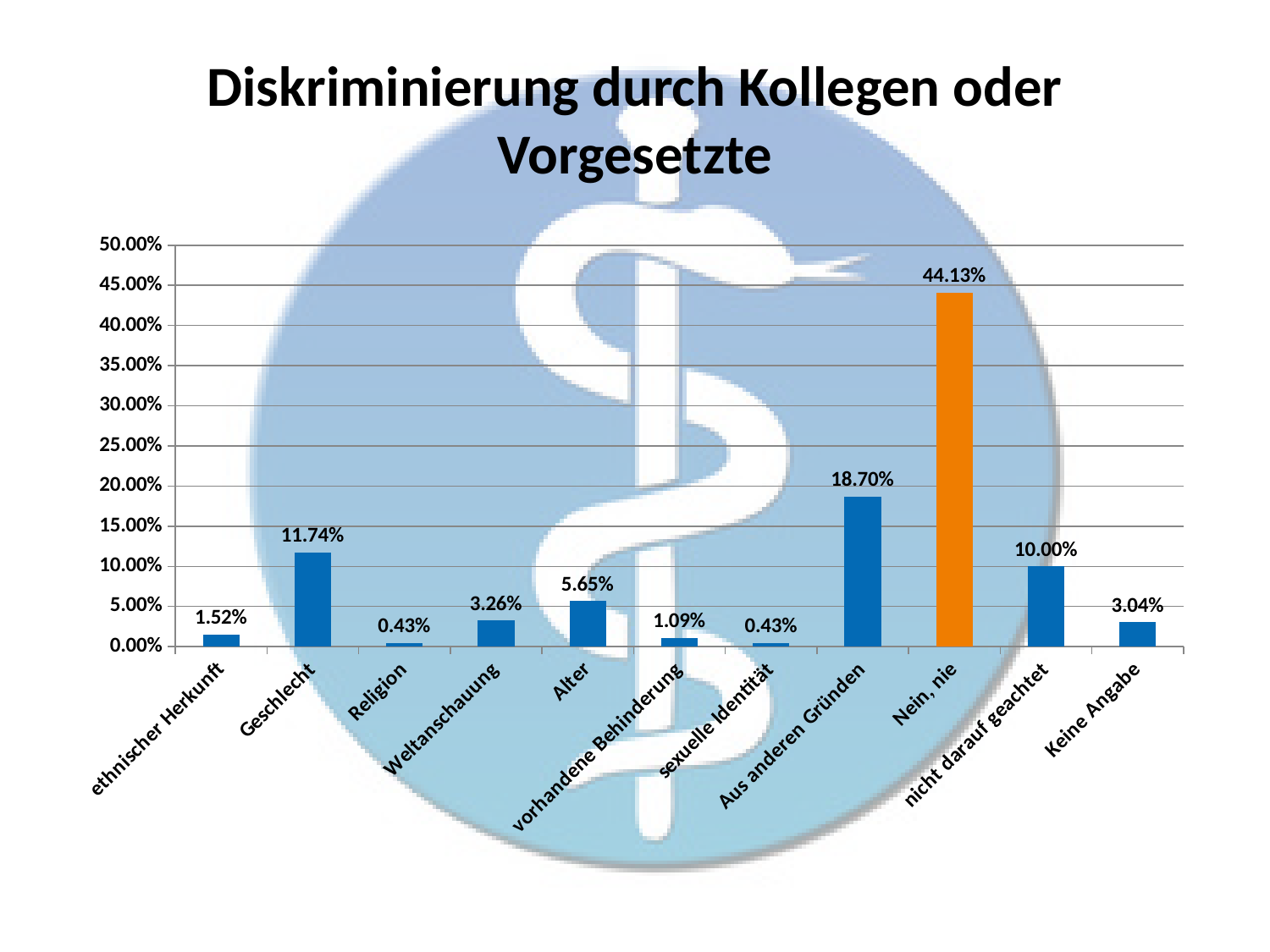
What is the difference between the values for Nein, nie and Aus anderen Gründen? 25.43% What is the value for Geschlecht? 11.74% What is the value for Alter? 5.65% What is the title of the chart? Diskriminierung durch Kollegen oder Vorgesetzte How many categories are shown on the x axis? 11 Which category has the highest value? Nein, nie Which is larger, the value for Weltanschauung or the value for Keine Angabe? Weltanschauung What kind of chart is shown on the slide? bar chart What is the difference between the values for Geschlecht and nicht darauf geachtet? 1.74% Is the value for Nein, nie greater or less than 40.00%? greater What is the value for nicht darauf geachtet? 10.00% What is the value for Aus anderen Gründen? 18.70%